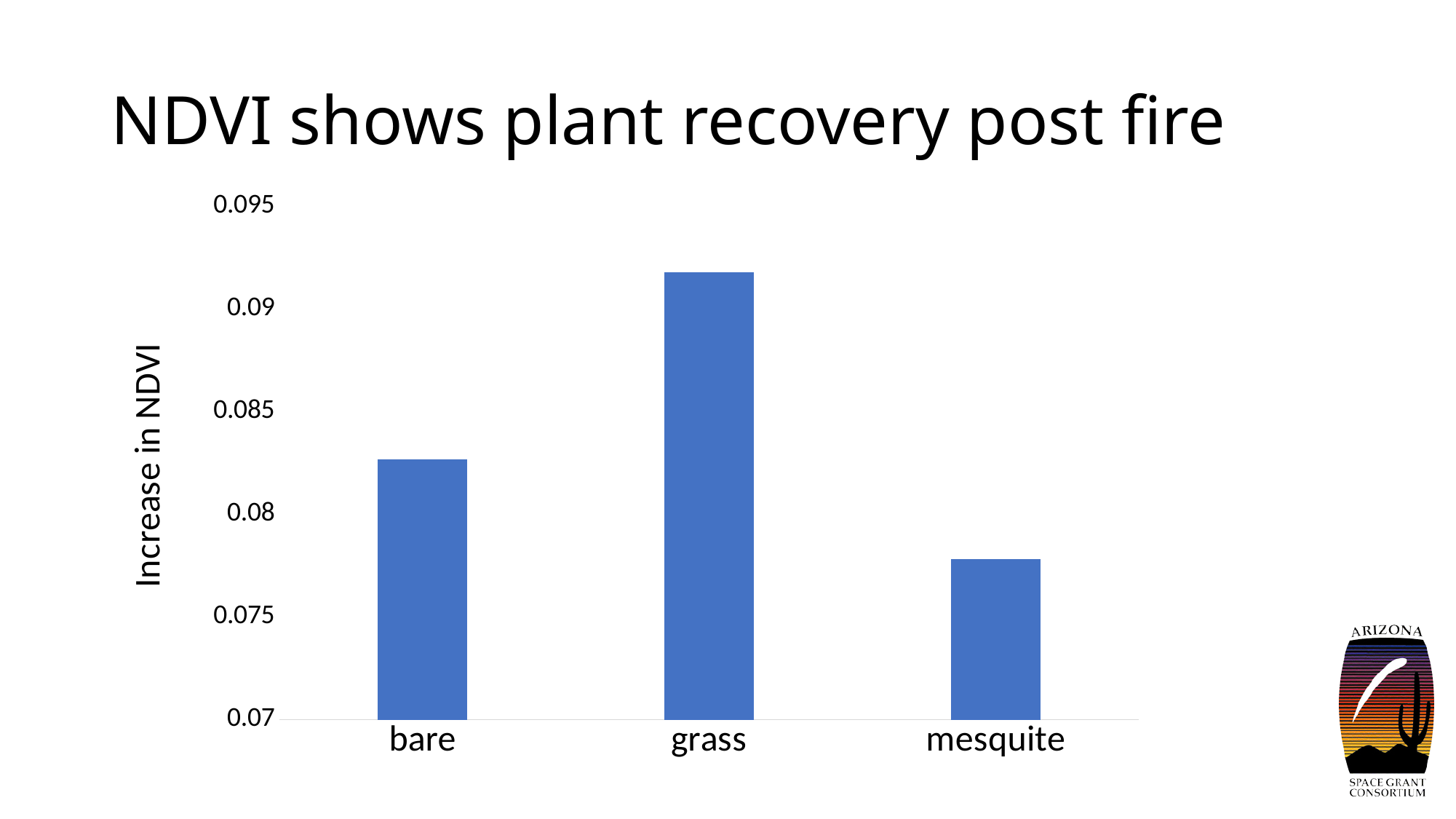
Which is larger, the value for bare or the value for mesquite? bare What is the title of the slide containing the chart? NDVI shows plant recovery post fire Is the value for bare greater or less than 0.085? less What kind of chart is shown on the slide? bar chart What is the label on the vertical axis of the chart? Increase in NDVI Is the value for bare greater or less than 0.08? greater Which category has the highest increase in NDVI? grass Which is larger, the value for grass or the value for bare? grass Is the value for mesquite greater or less than 0.08? less Which category has the lowest increase in NDVI? mesquite How many categories are plotted on the chart? 3